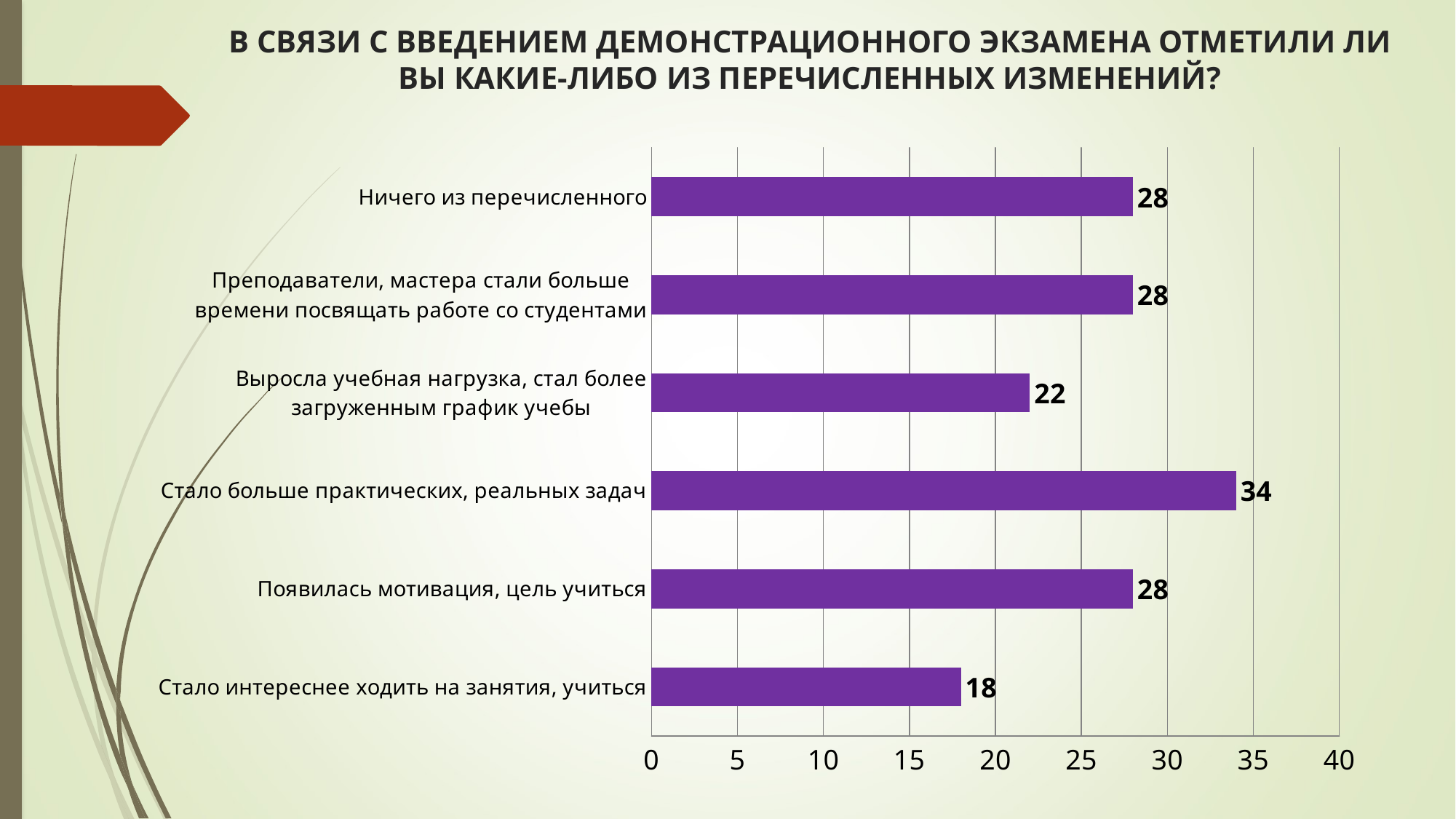
How many categories are shown in the chart? 6 Which is larger: the value for "Выросла учебная нагрузка, стал более загруженным график учебы" or the value for "Появилась мотивация, цель учиться"? Появилась мотивация, цель учиться Is the value for "Стало больше практических, реальных задач" greater or less than 30? greater What is the value for "Появилась мотивация, цель учиться"? 28 What is the value for "Стало больше практических, реальных задач"? 34 What is the difference between the values for "Стало больше практических, реальных задач" and "Стало интереснее ходить на занятия, учиться"? 16 Which category has the lowest value? Стало интереснее ходить на занятия, учиться Which category has the highest value? Стало больше практических, реальных задач What kind of chart is shown on the slide? bar chart What is the value for "Стало интереснее ходить на занятия, учиться"? 18 What is the value for "Выросла учебная нагрузка, стал более загруженным график учебы"? 22 What is the difference between the values for "Ничего из перечисленного" and "Выросла учебная нагрузка, стал более загруженным график учебы"? 6